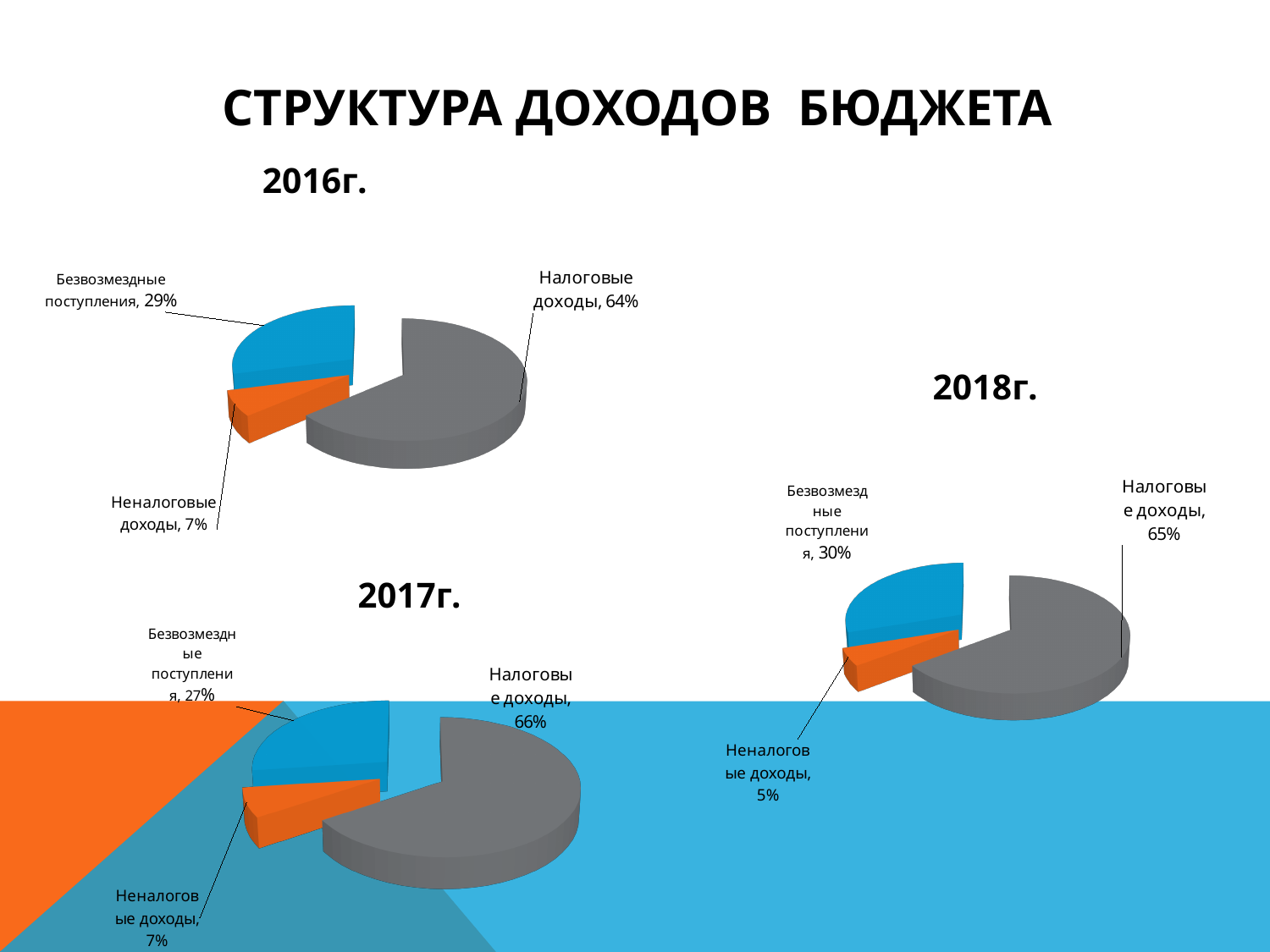
Which is larger: the share of Налоговые доходы in the 2017г. chart or in the 2018г. chart? 2017г. In the 2017г. chart, what share do Неналоговые доходы have? 7% In the 2017г. chart, what colour is the Неналоговые доходы slice? Orange How many categories does the 2018г. chart show? 3 In the 2018г. chart, what share do Безвозмездные поступления have? 30% What is the title of the slide containing the three charts? СТРУКТУРА ДОХОДОВ БЮДЖЕТА In the 2016г. chart, what share do Налоговые доходы have? 64% In the 2016г. chart, what is the difference between the shares of Налоговые доходы and Безвозмездные поступления? 35% In the 2018г. chart, which category has the smallest share? Неналоговые доходы What kind of chart is the 2016г. chart? Pie chart In the 2017г. chart, which category has the largest share? Налоговые доходы In the 2016г. chart, what share do Безвозмездные поступления have? 29%